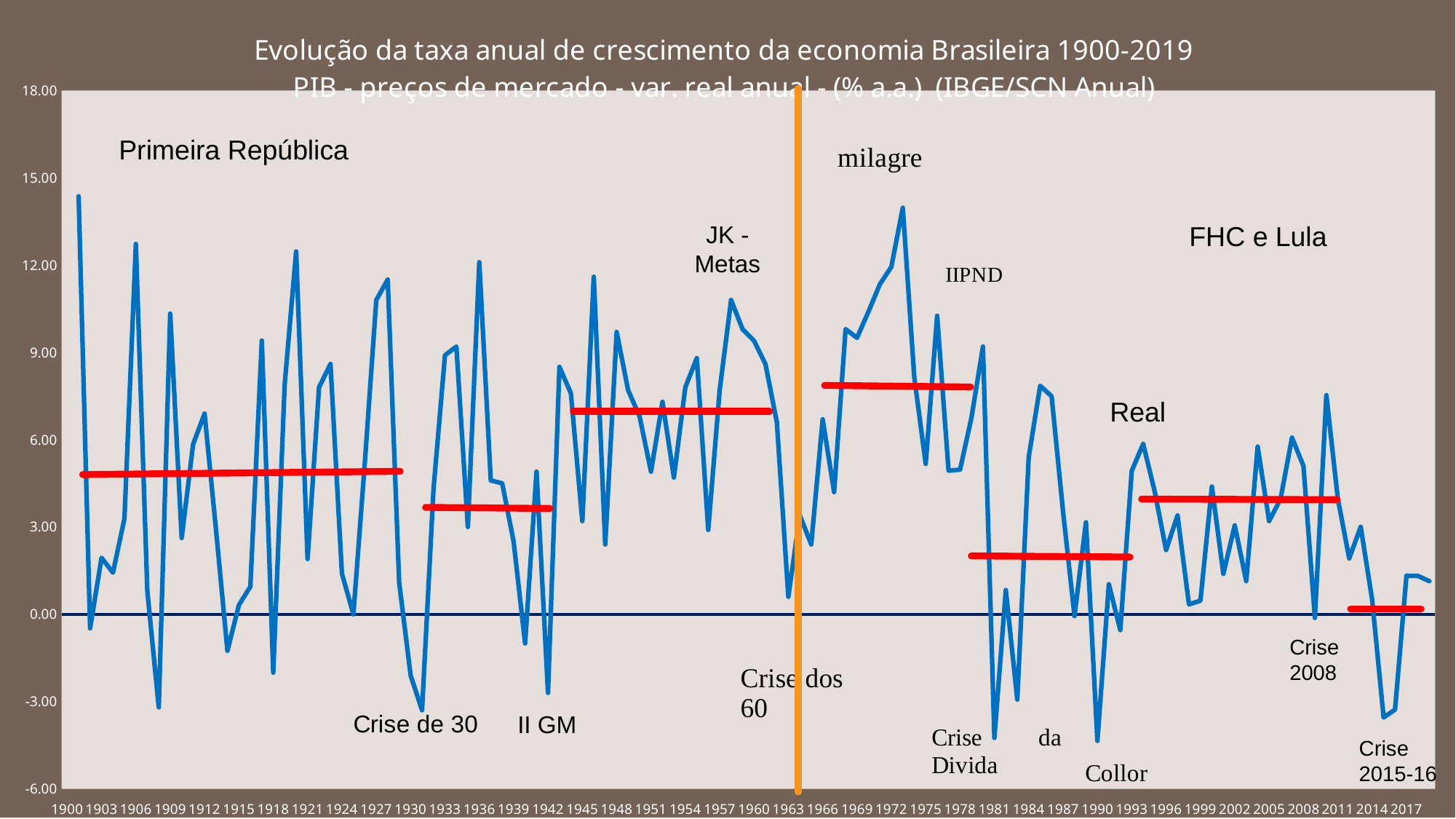
Is the red average line for the 1981-1993 period greater or less than 3.00? less Is the value for 1990 greater or less than -3.00? less Which is higher: the red average line for the 'Primeira República' period or the red average line for the 'milagre' period? milagre Is the value for 1942 greater or less than 0.00? less What colour is the line plotting the annual growth rate? blue Does the growth rate rise or fall from 1970 to 1973? rise What is the title of the chart? Evolução da taxa anual de crescimento da economia Brasileira 1900-2019 PIB - preços de mercado - var. real anual - (% a.a.) (IBGE/SCN Anual) What kind of chart is shown on the slide? line chart